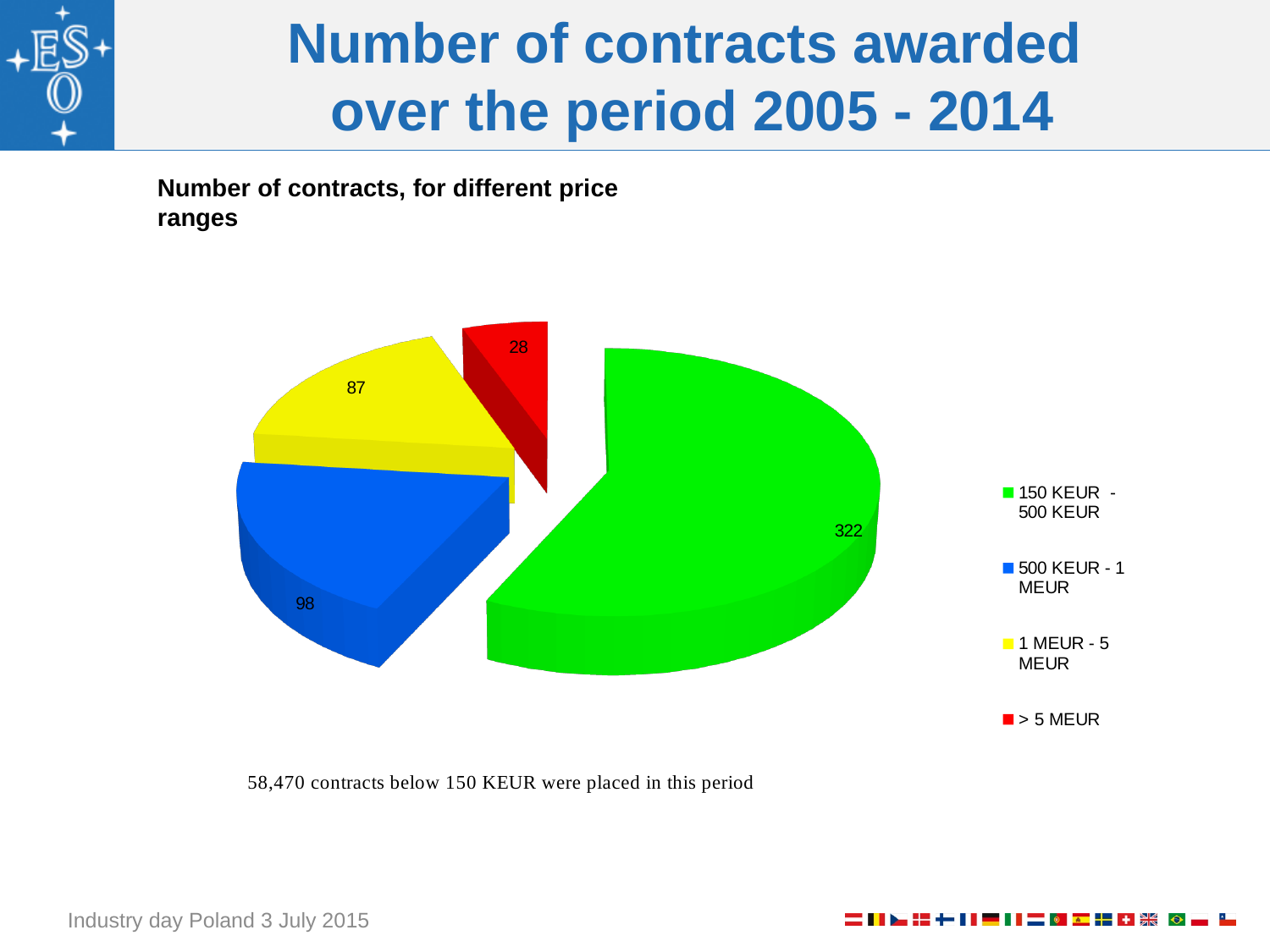
What type of chart is shown on the slide? Pie chart How many contracts were awarded in the 1 MEUR - 5 MEUR price range? 87 How many contracts were awarded in the > 5 MEUR price range? 28 Which price range has the largest number of contracts? 150 KEUR - 500 KEUR Which price range has the smallest number of contracts? > 5 MEUR Which has more contracts: the 500 KEUR - 1 MEUR range or the 1 MEUR - 5 MEUR range? 500 KEUR - 1 MEUR How many price ranges are shown in the pie chart? 4 How many contracts were awarded in the 150 KEUR - 500 KEUR price range? 322 What colour is the slice for the 150 KEUR - 500 KEUR price range? Green How many more contracts are in the 500 KEUR - 1 MEUR range than in the 1 MEUR - 5 MEUR range? 11 How many contracts were awarded in the 500 KEUR - 1 MEUR price range? 98 What is the difference between the number of contracts in the 150 KEUR - 500 KEUR range and the 500 KEUR - 1 MEUR range? 224